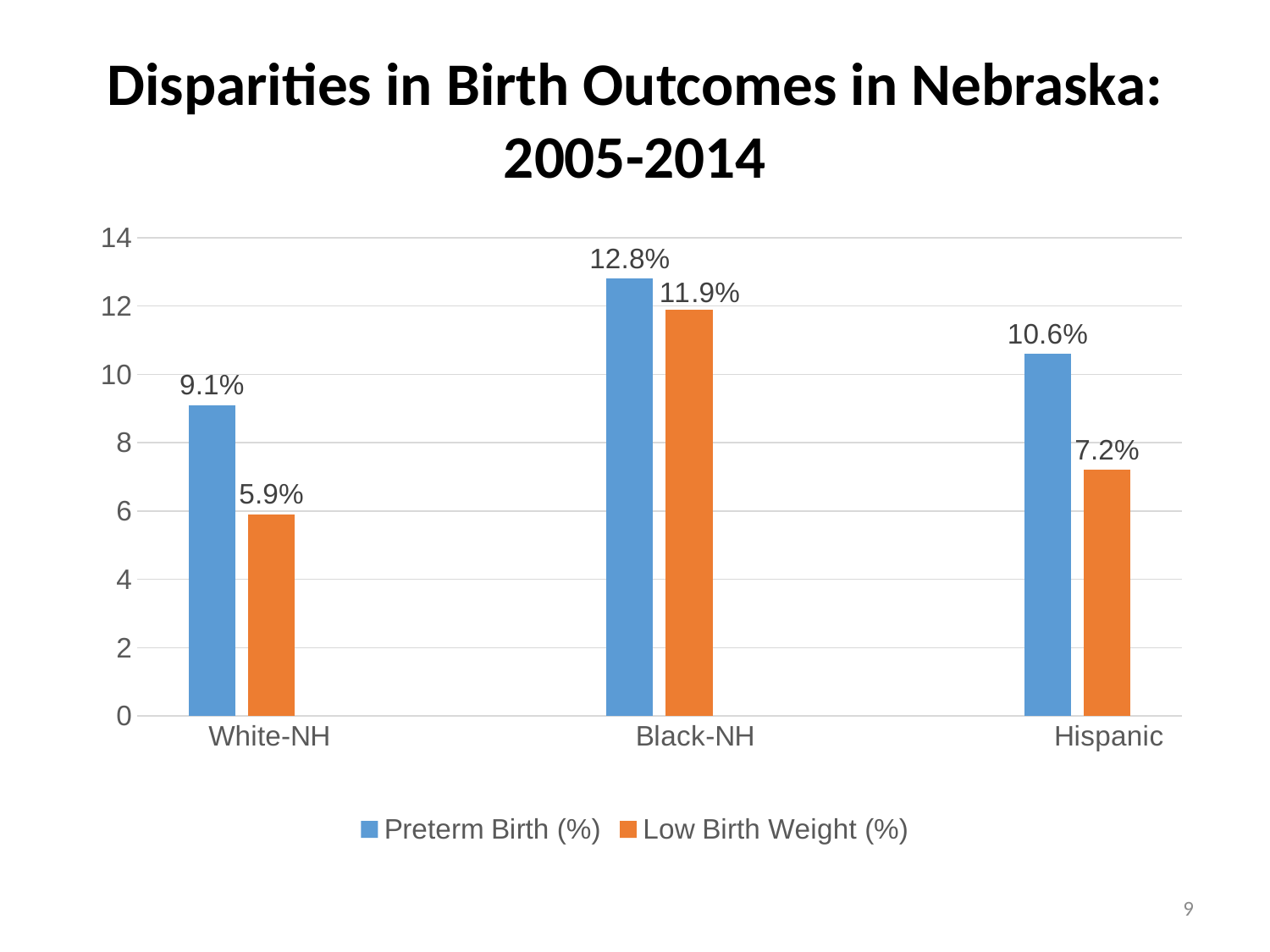
What is the Low Birth Weight (%) value for Hispanic? 7.2% What kind of chart is shown on the slide? bar chart What is the difference between the Preterm Birth (%) values for Black-NH and White-NH? 3.7% Which group has the highest Preterm Birth (%) value? Black-NH Which is larger: the Low Birth Weight (%) value for Hispanic or for White-NH? Hispanic Is the Preterm Birth (%) value for Hispanic greater or less than 10? greater How many series does the legend list? 2 What is the Preterm Birth (%) value for Black-NH? 12.8% Which group has the lowest Low Birth Weight (%) value? White-NH What is the difference between the Preterm Birth (%) and Low Birth Weight (%) values for Hispanic? 3.4% How many groups are shown on the x axis? 3 What is the Low Birth Weight (%) value for White-NH? 5.9%